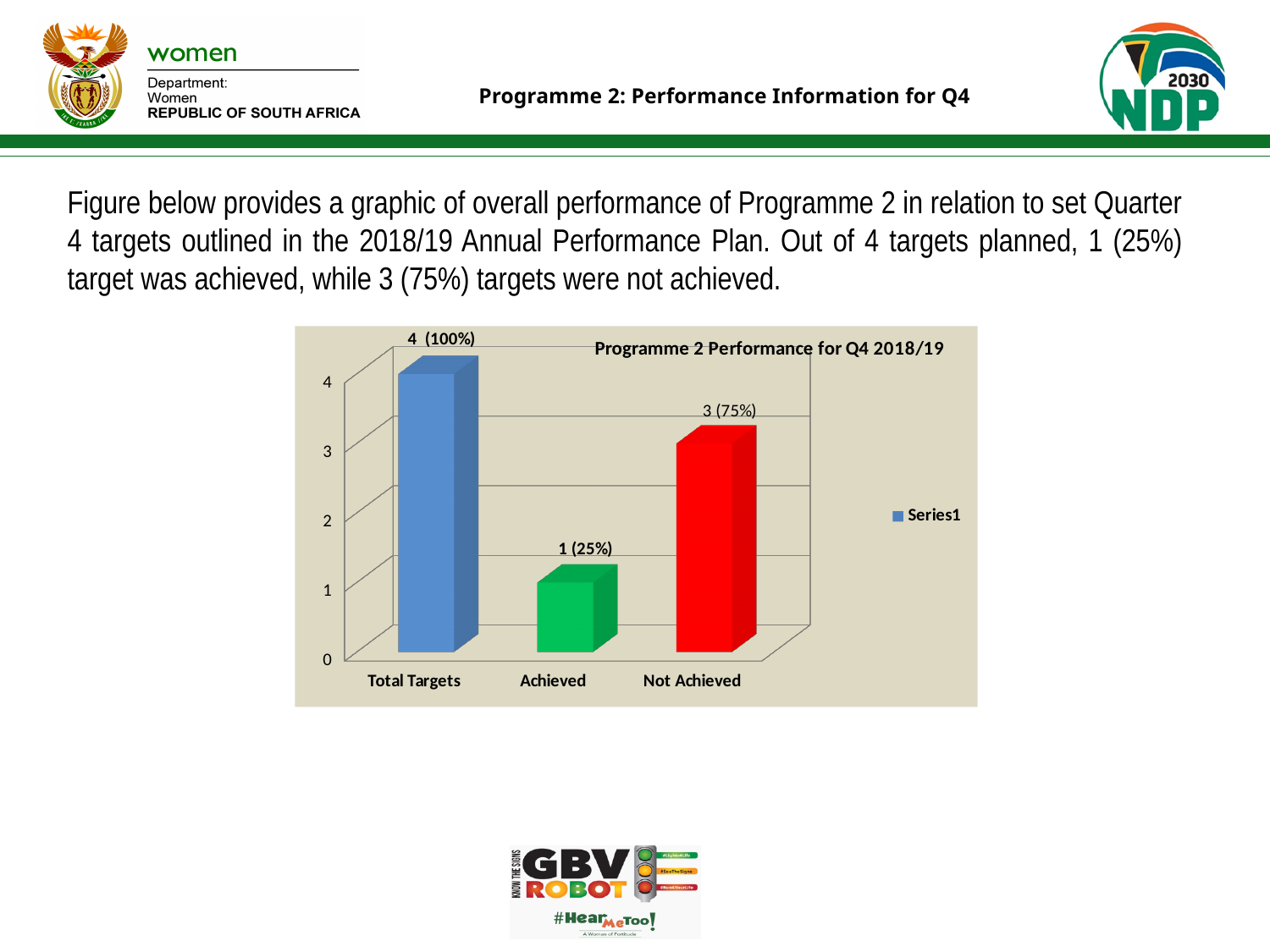
Which category has the lowest value? Achieved How many categories are shown on the x axis? 3 What is the value shown for Total Targets? 4 (100%) Is the value for Not Achieved greater or less than 2? greater What is the value shown for Not Achieved? 3 (75%) What is the difference between the Not Achieved and Achieved values? 2 Which is larger, the value for Achieved or the value for Not Achieved? Not Achieved What is the value shown for Achieved? 1 (25%) What kind of chart is shown? bar chart Which category has the highest value? Total Targets How many series does the legend list? 1 What is the title of the chart? Programme 2 Performance for Q4 2018/19